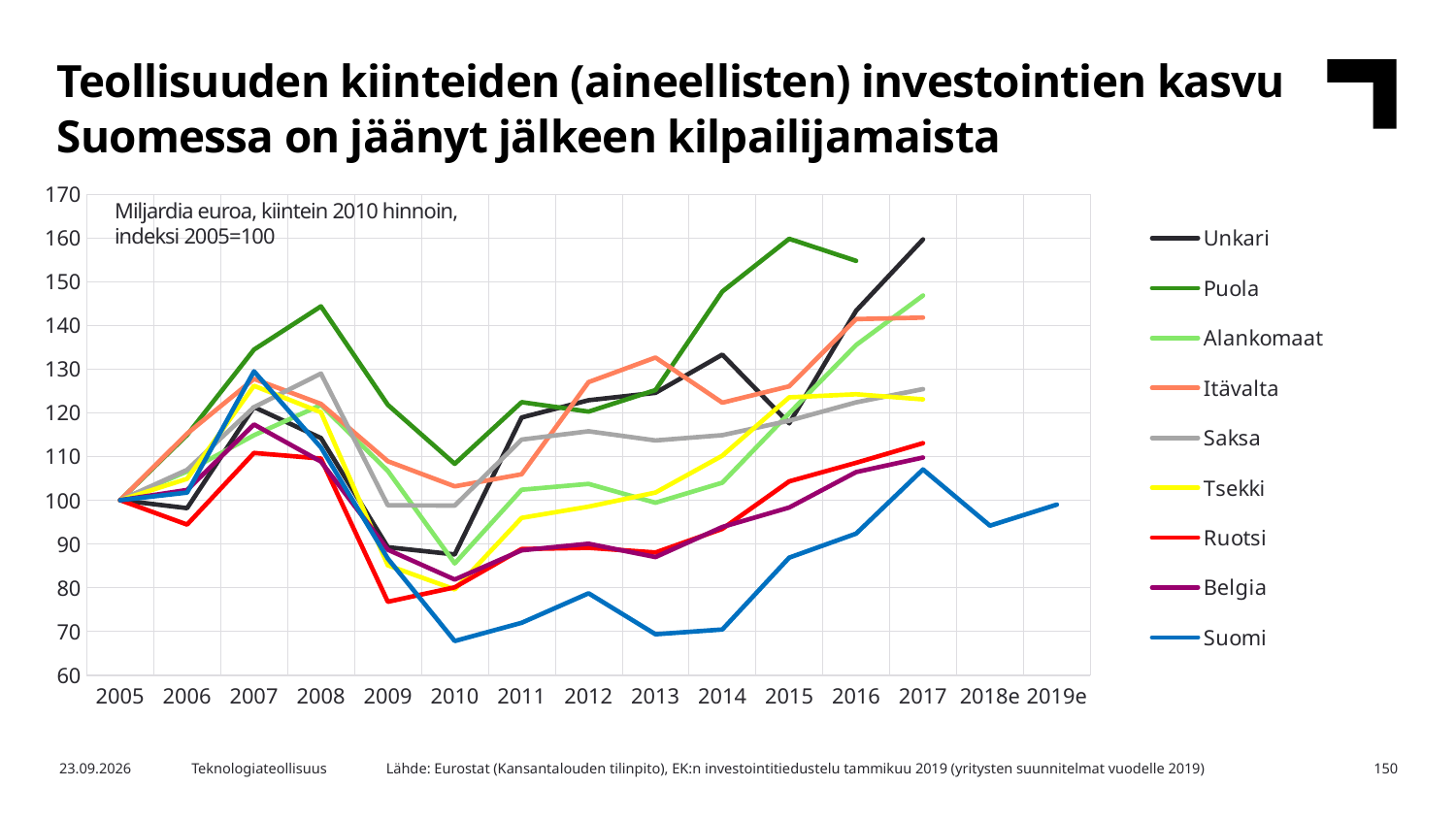
Which country has the highest value in 2015? Puola How many years are shown on the x axis? 15 Which country has the lowest value in 2014? Suomi Is the value for Suomi in 2010 greater or less than 80? less Is the value for Puola in 2015 greater or less than 150? greater Which is larger in 2016, the value for Puola or the value for Suomi? Puola Which country has the highest value in 2017? Unkari How many series does the legend list? 9 What kind of chart is shown on the slide? line chart What is the value for Suomi in 2005? 100 Does the value for Suomi rise or fall from 2014 to 2017? rise Is the value for Ruotsi in 2009 greater or less than 90? less